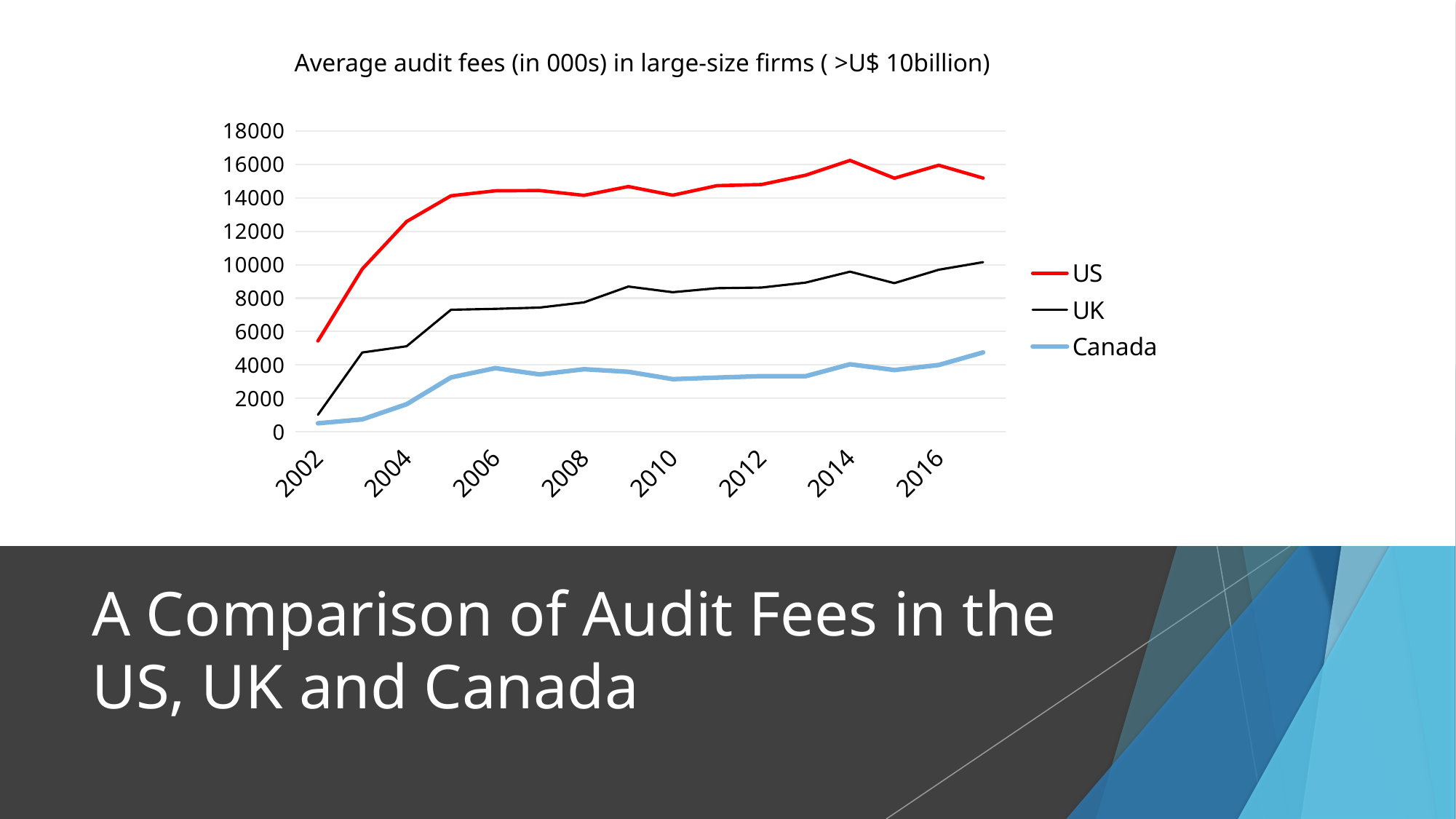
Is the value for US in 2014 greater or less than 15000? greater Which series has the highest value in 2016? US Is the value for UK in 2002 greater or less than 2000? less Does the US series rise or fall between 2002 and 2006? rise Which is larger in 2006, the value for UK or the value for Canada? UK Is the value for US in 2002 greater or less than 4000? greater What kind of chart is shown on the slide? line chart What is the title of the chart? Average audit fees (in 000s) in large-size firms ( >U$ 10billion) How many series does the legend list? 3 Which series has the lowest value in 2010? Canada Which series is drawn in red? US